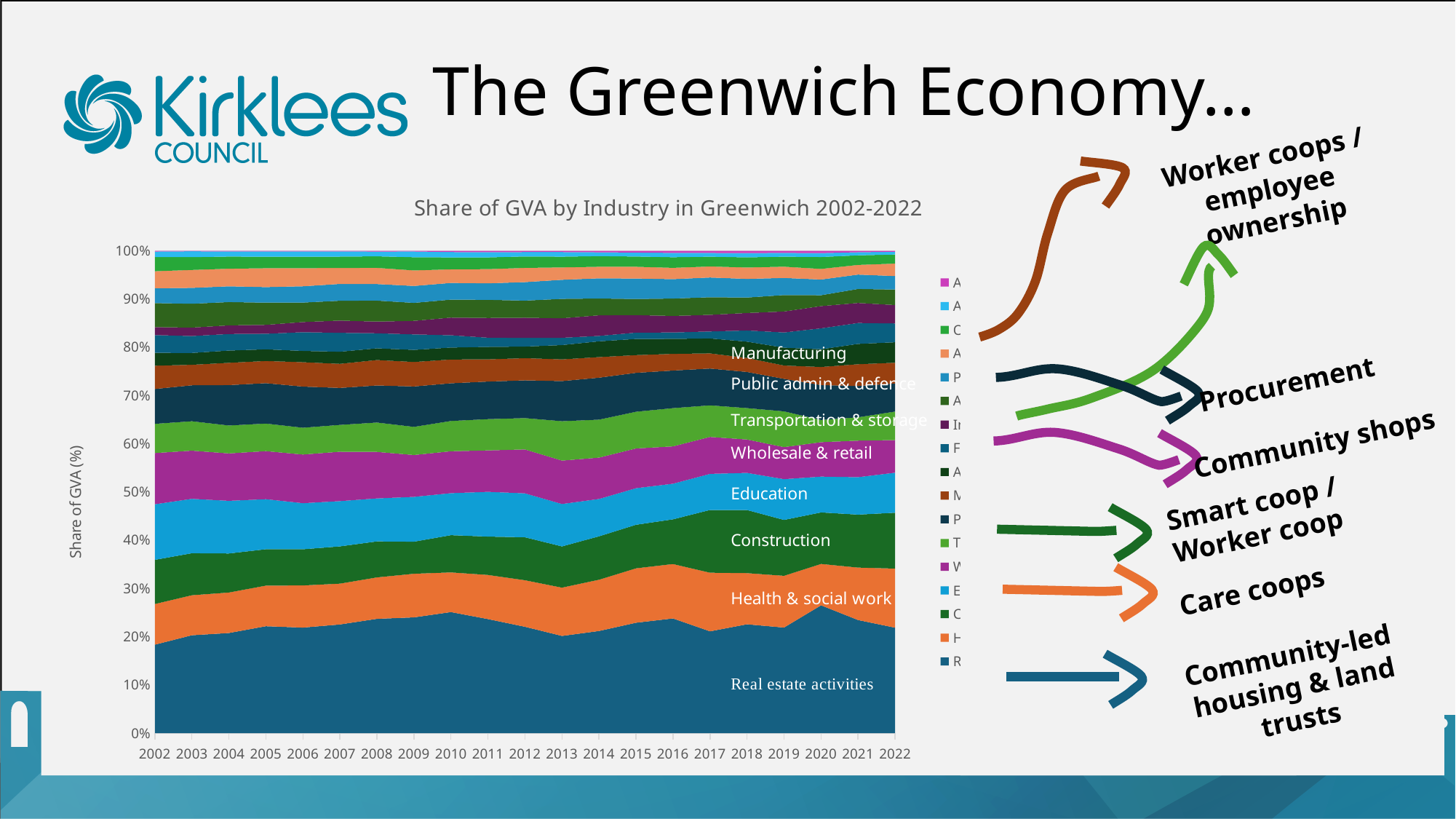
Is the cumulative share at the top of the Health & social work band in 2002 greater or less than 30%? less Which industry has the largest share of GVA in the chart? Real estate activities Which industry band sits directly above Real estate activities in the chart? Health & social work Is the cumulative share at the top of the Education band in 2017 greater or less than 50%? greater How many years are plotted along the x axis of the chart? 21 Which industry forms the bottom band of the stacked area chart? Real estate activities Does the share of GVA for Real estate activities rise or fall between 2002 and 2020? rise What is the title of the chart? Share of GVA by Industry in Greenwich 2002-2022 Which of the two has the larger share of GVA in 2022: Real estate activities or Manufacturing? Real estate activities What kind of chart is shown on the slide? Stacked area chart What is the label on the vertical axis of the chart? Share of GVA (%) Is the share of GVA for Real estate activities in 2020 greater or less than 20%? greater